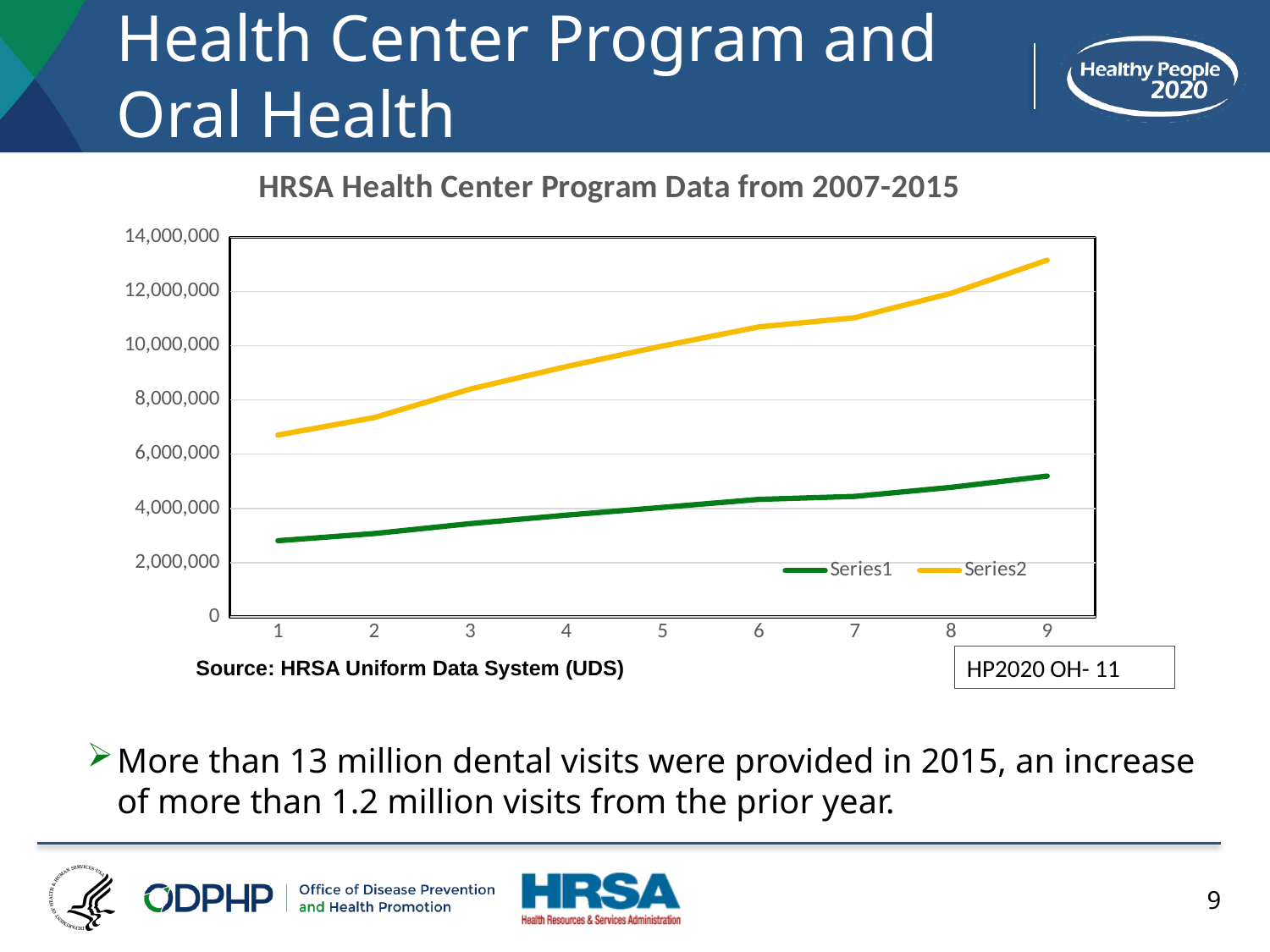
Is the value for Series2 at point 9 greater or less than 12,000,000? greater Is the value for Series2 at point 1 greater or less than 8,000,000? less At which x-axis point is Series1 lowest? 1 What kind of chart is shown on the slide? line chart How many points are plotted along the x axis for each series? 9 What is the title of the chart? HRSA Health Center Program Data from 2007-2015 At point 9, which series has the larger value, Series1 or Series2? Series2 How many series does the chart legend list? 2 Do the values for Series2 rise or fall from point 1 to point 9? rise At which x-axis point is Series2 highest? 9 Do the values for Series1 rise or fall along the x axis? rise Is the value for Series1 at point 9 greater or less than 4,000,000? greater